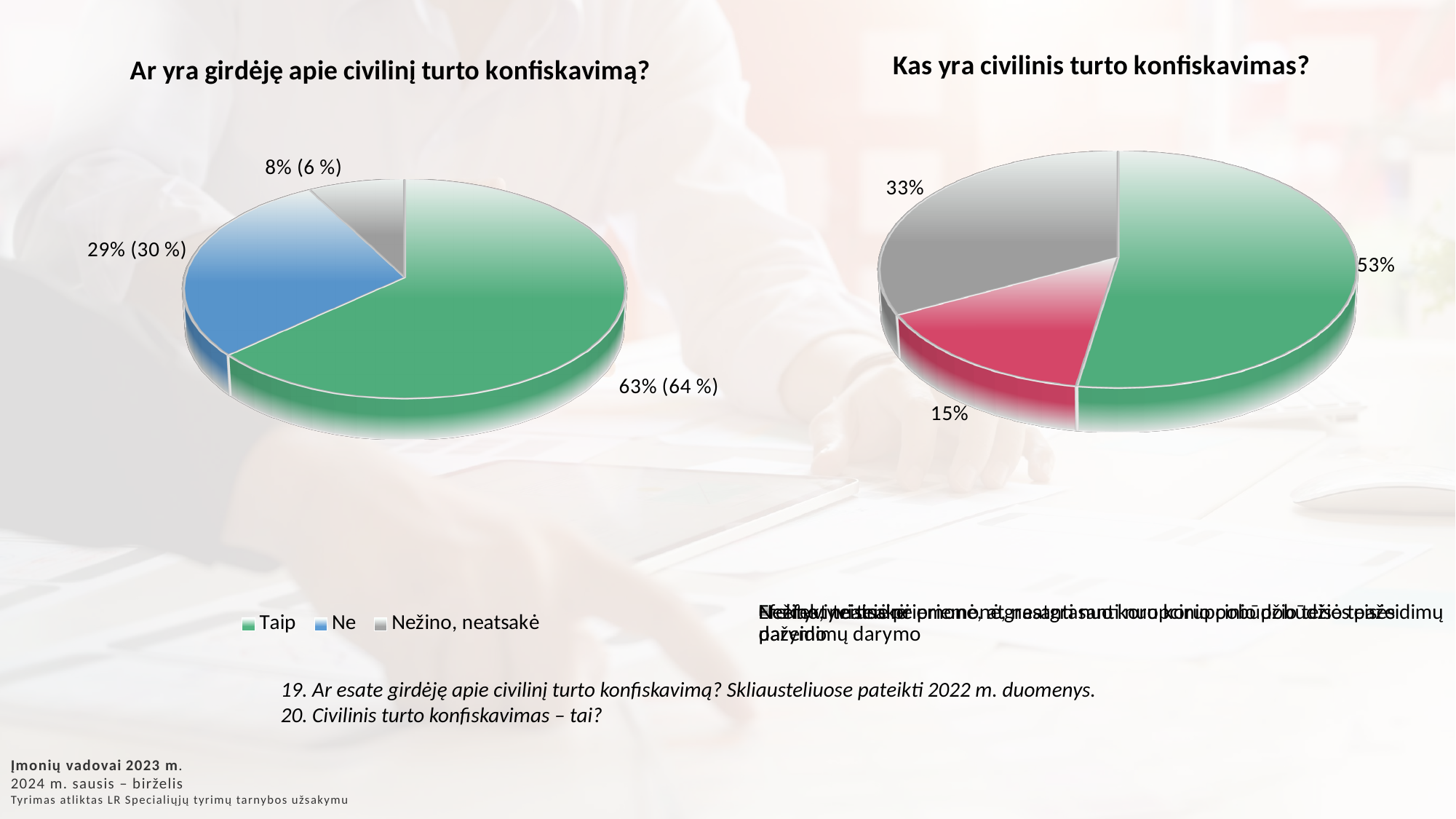
In the right chart "Kas yra civilinis turto konfiskavimas?", what is the value of the red slice? 15% In the left chart "Ar yra girdėję apie civilinį turto konfiskavimą?", what is the value for "Taip"? 63% (64 %) In the left chart "Ar yra girdėję apie civilinį turto konfiskavimą?", what is the value for "Nežino, neatsakė"? 8% (6 %) In the right chart "Kas yra civilinis turto konfiskavimas?", what is the value of the grey slice? 33% In the left chart "Ar yra girdėję apie civilinį turto konfiskavimą?", which category has the smallest share? Nežino, neatsakė In the left chart "Ar yra girdėję apie civilinį turto konfiskavimą?", what is the value for "Ne"? 29% (30 %) What kind of chart is the left chart "Ar yra girdėję apie civilinį turto konfiskavimą?"? Pie chart In the left chart "Ar yra girdėję apie civilinį turto konfiskavimą?", how many categories does the legend list? 3 In the right chart "Kas yra civilinis turto konfiskavimas?", how many slices does the pie have? 3 In the left chart "Ar yra girdėję apie civilinį turto konfiskavimą?", what is the difference in percentage points between the 2023 values for "Taip" and "Ne"? 34 In the right chart "Kas yra civilinis turto konfiskavimas?", what is the value of the green slice? 53% In the left chart "Ar yra girdėję apie civilinį turto konfiskavimą?", which category has the largest share? Taip